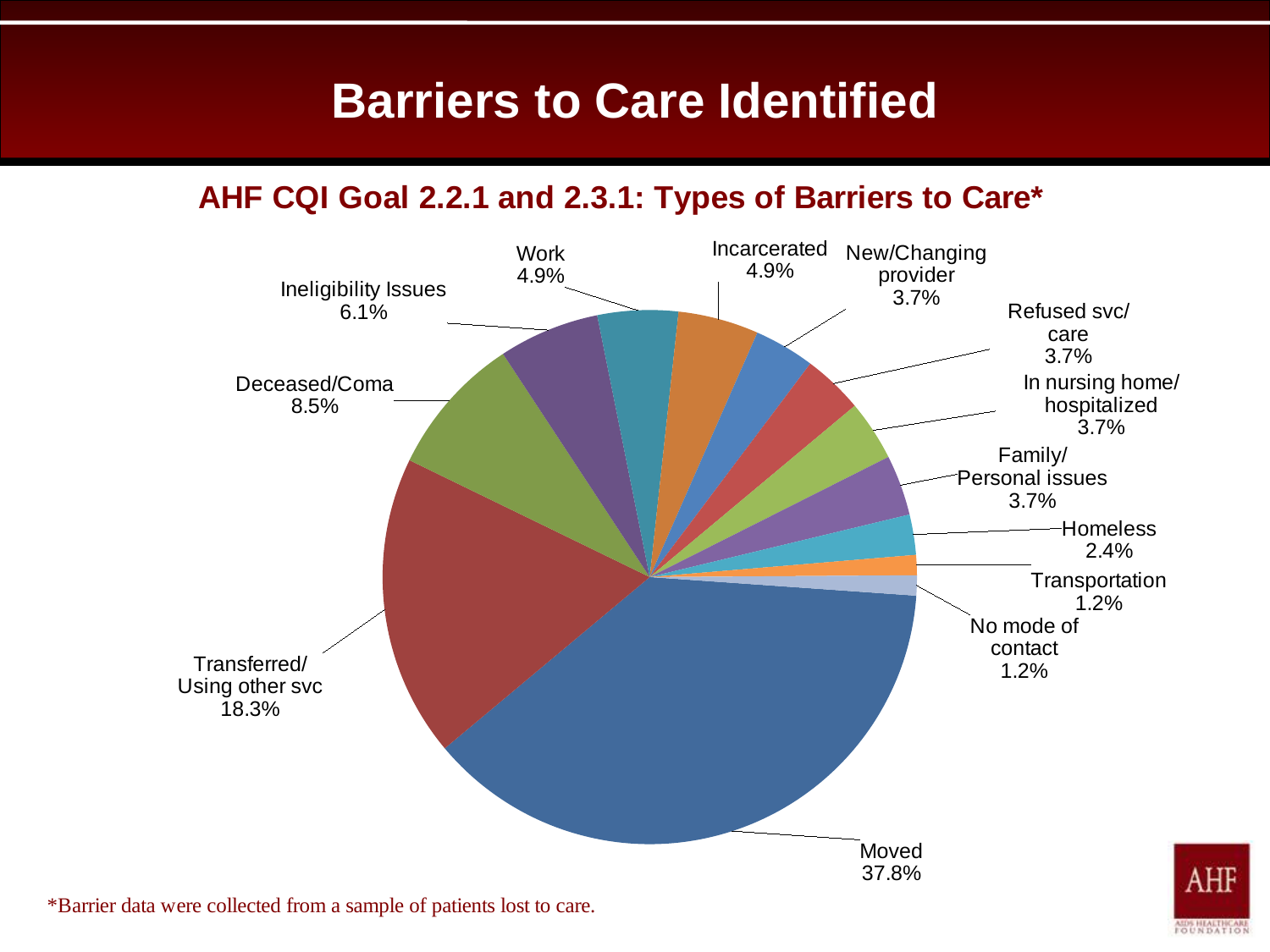
What is the value for Transferred/Using other svc? 18.3% How many categories are shown in the pie chart? 13 What type of chart is shown on the slide? Pie chart What percentage is shown for Deceased/Coma? 8.5% Which barrier category has the largest share of the pie? Moved What is the combined share of Transportation and No mode of contact? 2.4% What is the value for Homeless? 2.4% What percentage of barriers to care is attributed to Moved? 37.8% What is the difference between the Moved share and the Transferred/Using other svc share? 19.5% Which is larger, Ineligibility Issues or Work? Ineligibility Issues What percentage is shown for Incarcerated? 4.9% What is the title of the chart? AHF CQI Goal 2.2.1 and 2.3.1: Types of Barriers to Care*